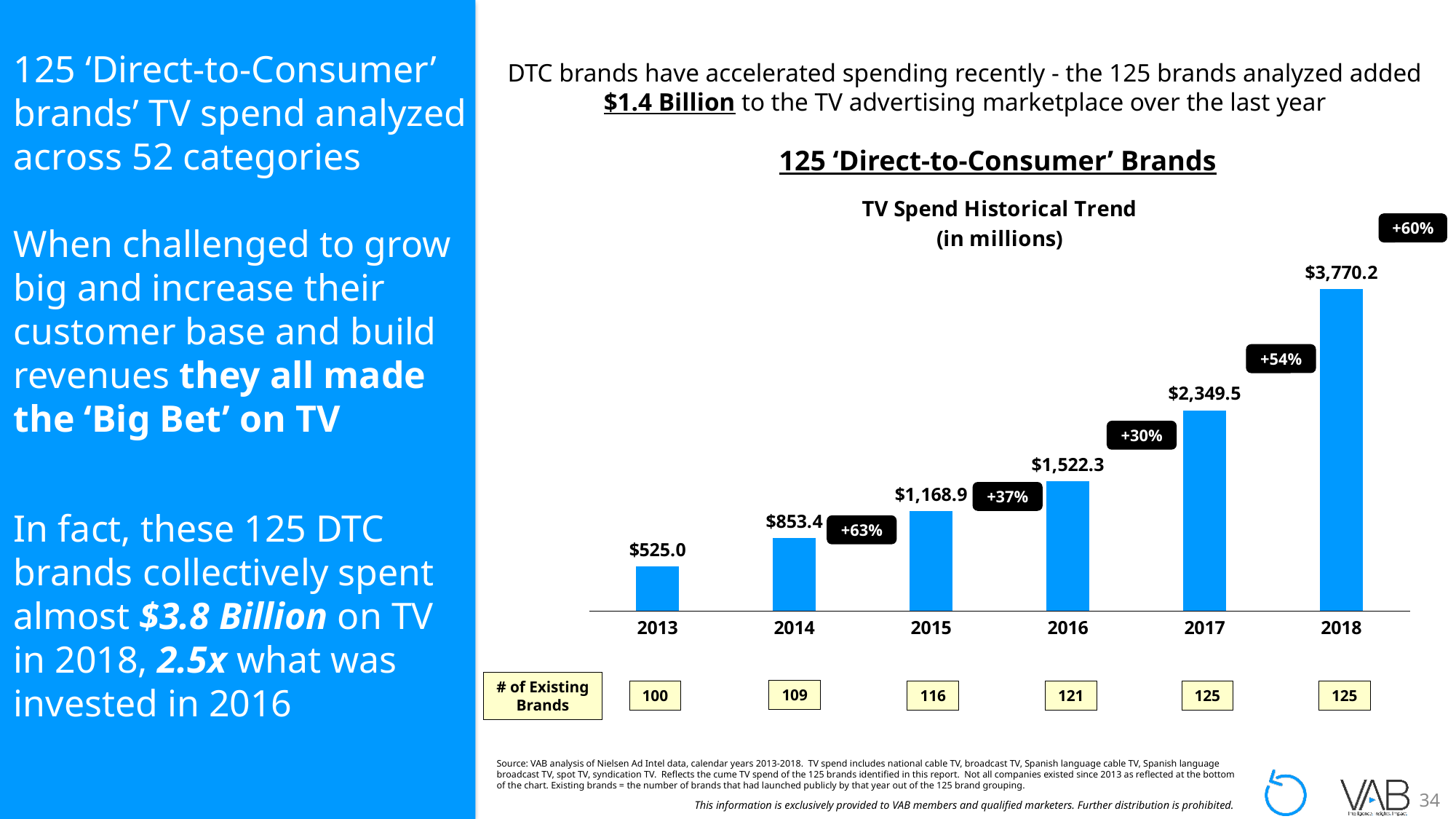
What unit is the TV spend shown in, according to the chart subtitle? In millions What percentage growth is shown between 2017 and 2018? +60% Which year had a larger TV spend, 2015 or 2016? 2016 Do TV spend values rise or fall from 2013 to 2018? Rise Which year has the lowest TV spend? 2013 What was the TV spend in 2018? $3,770.2 What kind of chart is shown? Bar chart How many years are shown on the chart? 6 What was the TV spend in 2013? $525.0 What was the TV spend in 2016? $1,522.3 Which year has the highest TV spend? 2018 What is the difference in TV spend between 2018 and 2017? $1,420.7